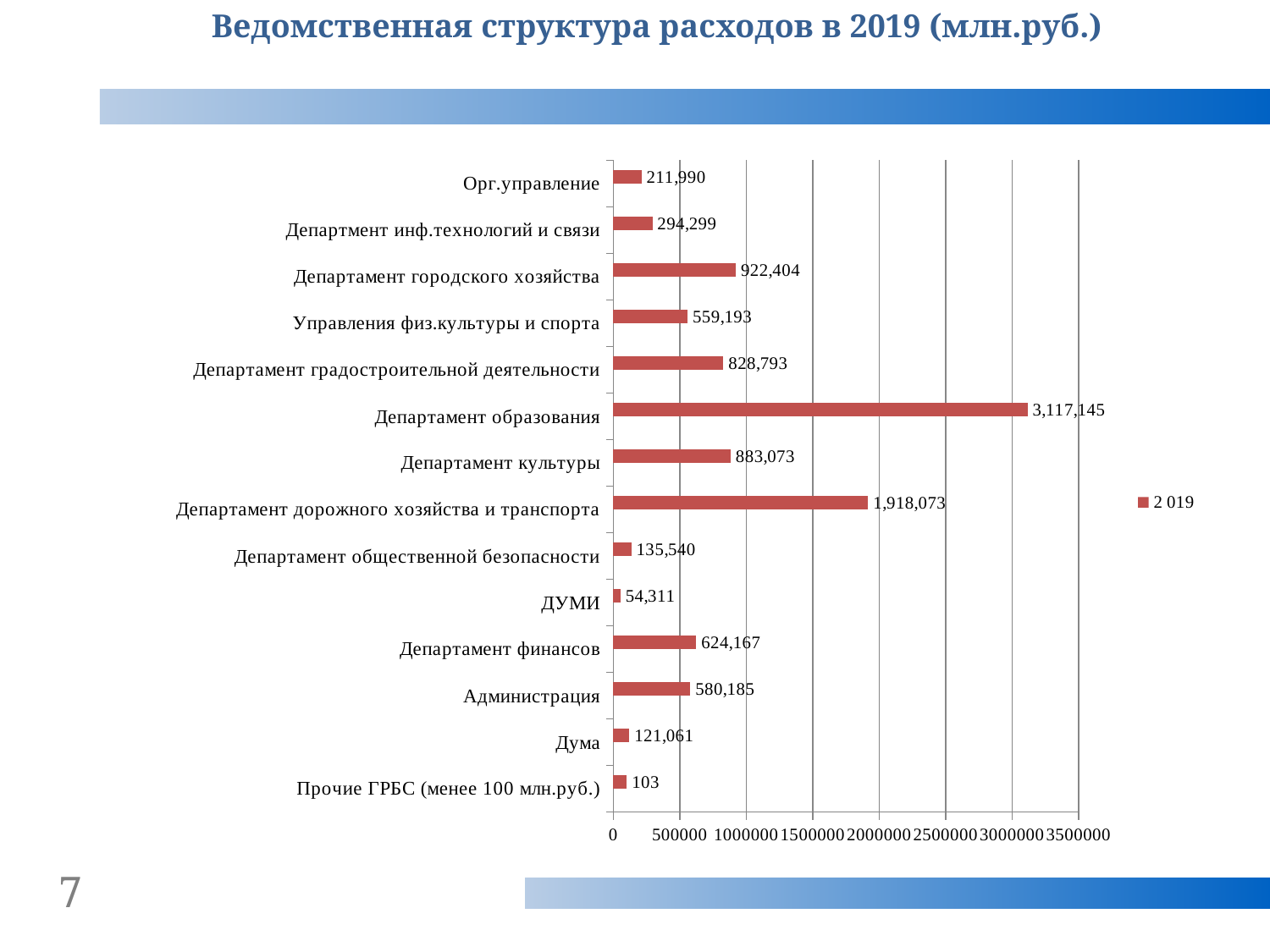
Which is larger: the value for Департамент городского хозяйства or Департамент культуры? Департамент городского хозяйства What is the value for Департамент образования? 3,117,145 What is the legend entry shown for the series? 2 019 What is the value for Администрация? 580,185 How many series does the legend list? 1 Is the value for Департамент дорожного хозяйства и транспорта greater or less than 1500000? greater What kind of chart is shown on the slide? bar chart What is the difference between the values for Департамент образования and Департамент дорожного хозяйства и транспорта? 1,199,072 What is the value for Департамент дорожного хозяйства и транспорта? 1,918,073 What is the value for ДУМИ? 54,311 Which category has the highest value? Департамент образования How many categories are shown in the chart? 14